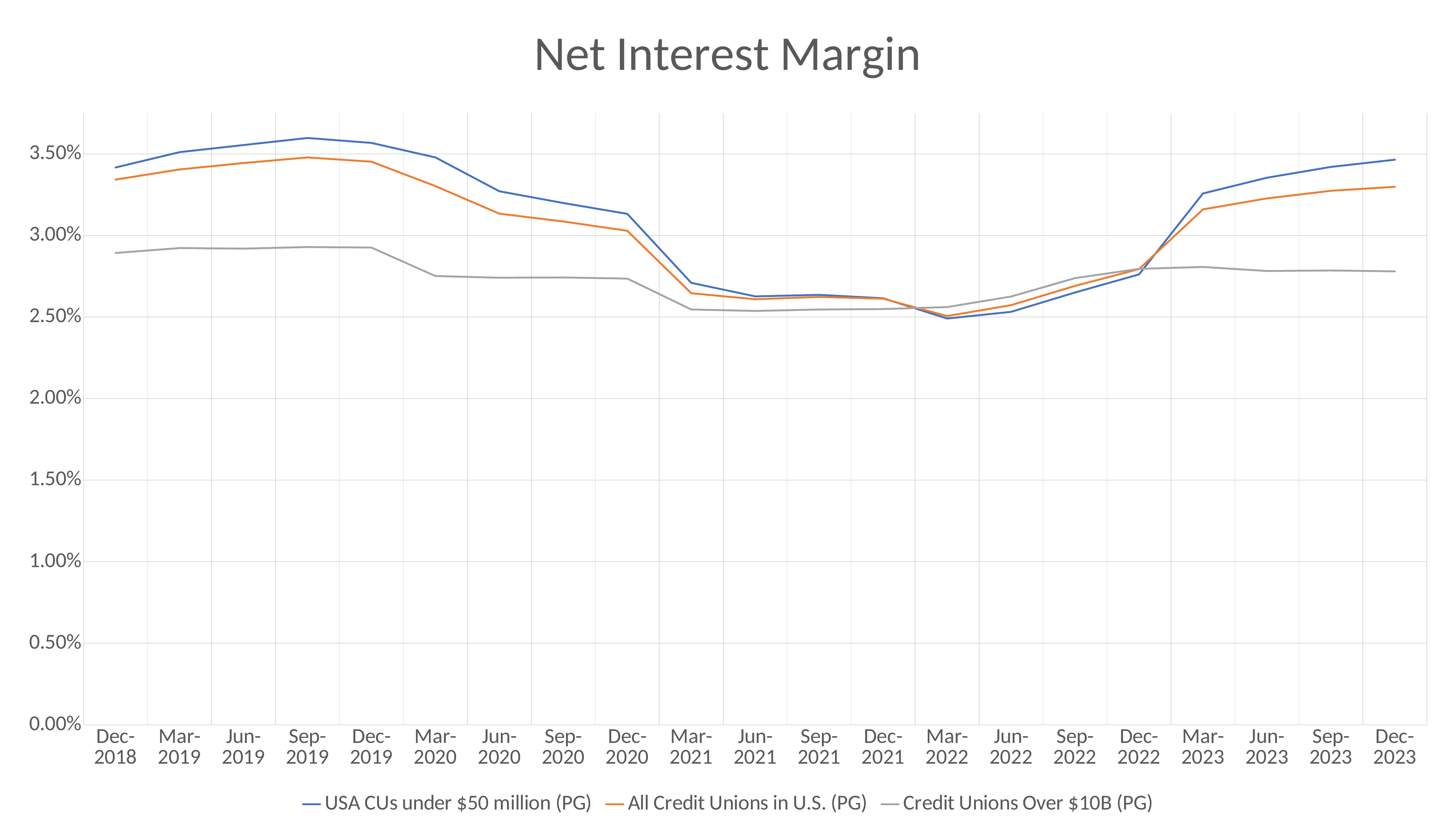
Is the value for Credit Unions Over $10B (PG) at Dec-2023 greater or less than 3.00%? less Does the USA CUs under $50 million (PG) line rise or fall from Dec-2022 to Dec-2023? Rise What is the title of the chart? Net Interest Margin How many time points are shown along the x axis? 21 Is the value for USA CUs under $50 million (PG) at Sep-2019 greater or less than 3.50%? greater At Dec-2018, which series has the higher value: USA CUs under $50 million (PG) or Credit Unions Over $10B (PG)? USA CUs under $50 million (PG) Is the value for USA CUs under $50 million (PG) at Jun-2020 greater or less than 3.00%? greater Which series is drawn in orange? All Credit Unions in U.S. (PG) At which time point does USA CUs under $50 million (PG) reach its lowest value? Mar-2022 How many series does the legend list? 3 What kind of chart is shown on the slide? Line chart